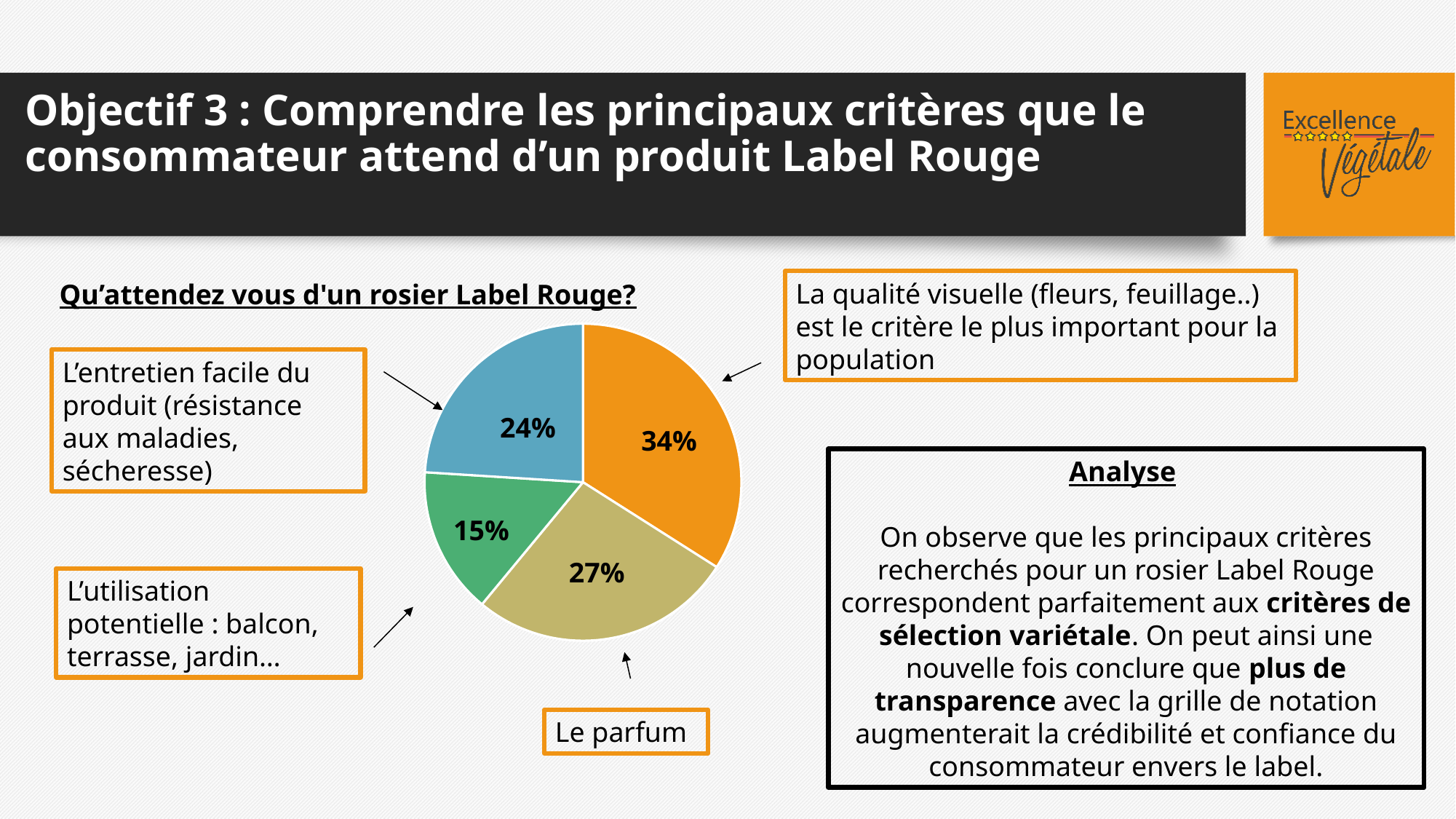
Which criterion has the smallest slice of the pie? L'utilisation potentielle : balcon, terrasse, jardin… What share of the pie corresponds to 'Le parfum'? 27% Which is larger: the slice for 'L'entretien facile du produit' or the slice for 'L'utilisation potentielle'? L'entretien facile du produit What share of the pie corresponds to 'L'entretien facile du produit'? 24% How many slices does the pie chart have? 4 What share of the pie corresponds to 'L'utilisation potentielle : balcon, terrasse, jardin…'? 15% What is the difference in percentage points between the 'qualité visuelle' slice and the 'parfum' slice? 7 What kind of chart is shown on the slide? pie chart What share of the pie corresponds to 'La qualité visuelle (fleurs, feuillage..)'? 34% What is the question shown as the title above the pie chart? Qu'attendez vous d'un rosier Label Rouge? What colour is the slice labelled 34%? orange Which criterion has the largest slice of the pie? La qualité visuelle (fleurs, feuillage..)